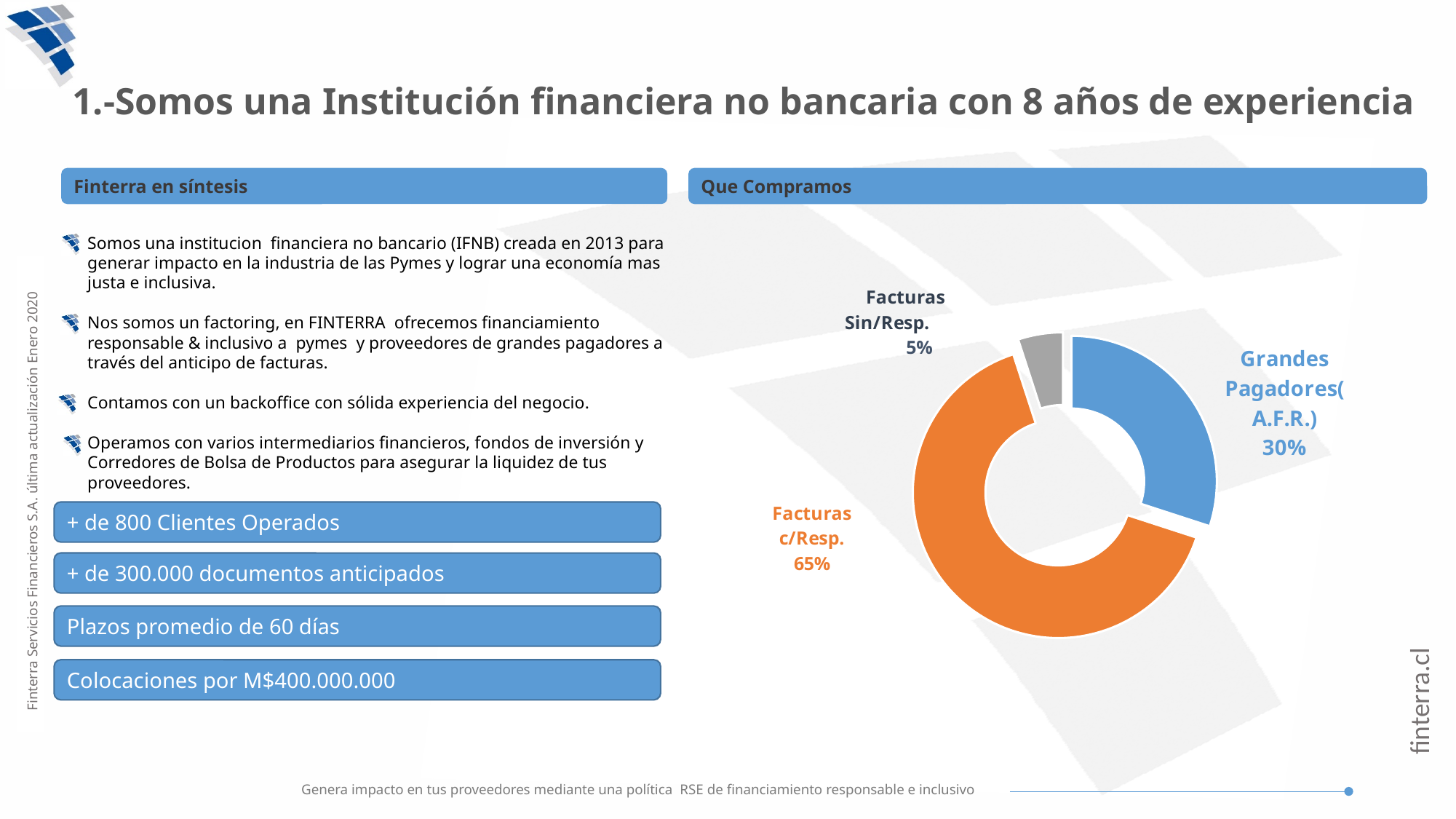
Which is larger in the doughnut chart, Grandes Pagadores (A.F.R.) or Facturas Sin/Resp.? Grandes Pagadores (A.F.R.) What colour is the Facturas c/Resp. segment in the doughnut chart? Orange What share of the doughnut chart is Facturas c/Resp.? 65% What share of the doughnut chart is Grandes Pagadores (A.F.R.)? 30% Which category has the largest share in the doughnut chart? Facturas c/Resp. What kind of chart is shown under "Que Compramos"? Doughnut chart What is the heading above the doughnut chart? Que Compramos How many categories are shown in the doughnut chart? 3 What is the difference in percentage points between Facturas c/Resp. and Grandes Pagadores (A.F.R.)? 35 What share of the doughnut chart is Facturas Sin/Resp.? 5% What is the combined share of Facturas c/Resp. and Facturas Sin/Resp.? 70% Which category has the smallest share in the doughnut chart? Facturas Sin/Resp.